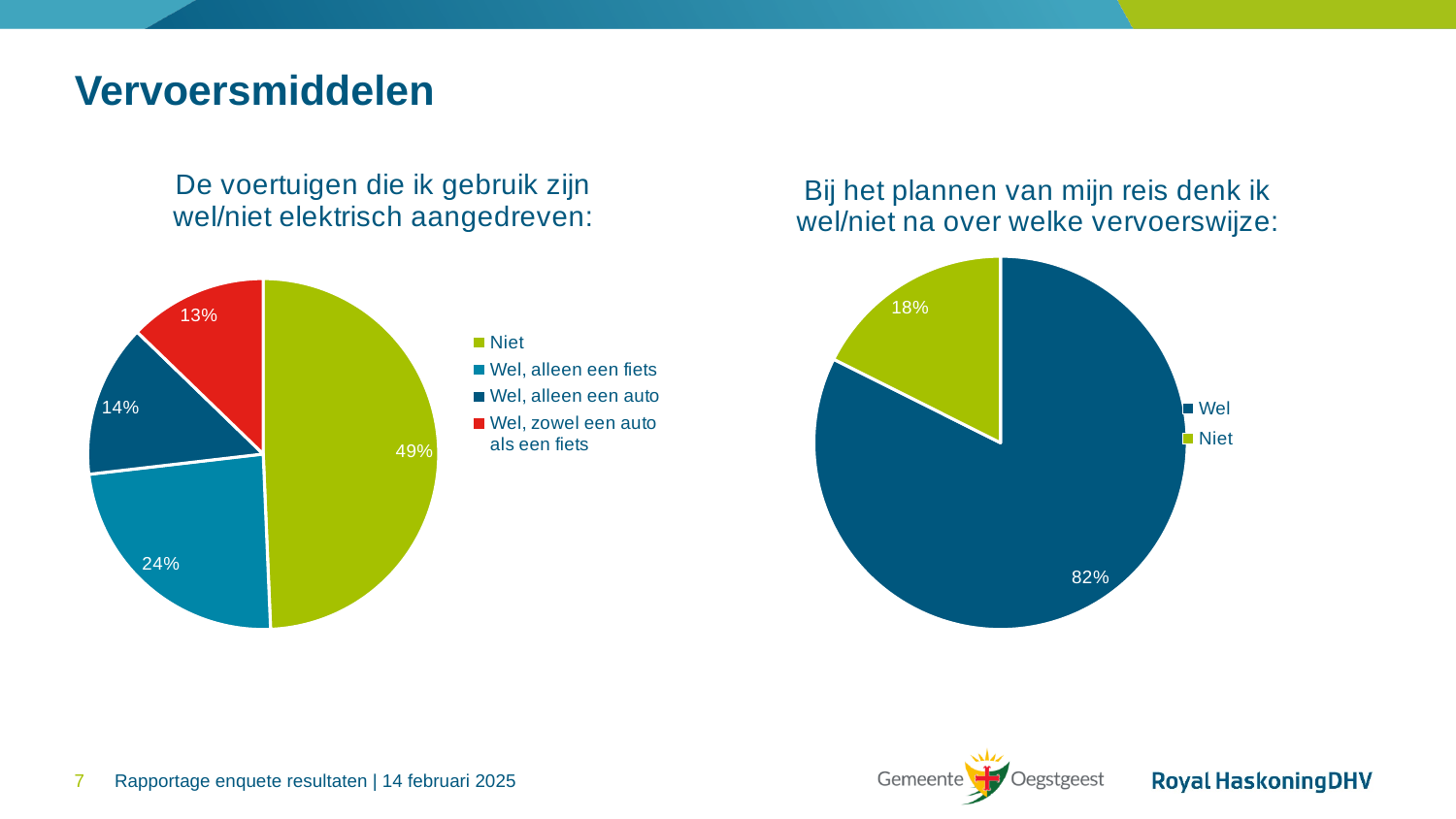
In the left chart (De voertuigen die ik gebruik zijn wel/niet elektrisch aangedreven), which category is shown in red? Wel, zowel een auto als een fiets In the right chart (Bij het plannen van mijn reis denk ik wel/niet na over welke vervoerswijze), what share is labelled for 'Niet'? 18% In the left chart (De voertuigen die ik gebruik zijn wel/niet elektrisch aangedreven), which category has the smallest slice? Wel, zowel een auto als een fiets In the left chart (De voertuigen die ik gebruik zijn wel/niet elektrisch aangedreven), how many categories does the legend list? 4 In the left chart (De voertuigen die ik gebruik zijn wel/niet elektrisch aangedreven), what share is labelled for 'Niet'? 49% In the right chart (Bij het plannen van mijn reis denk ik wel/niet na over welke vervoerswijze), which is larger, 'Wel' or 'Niet'? Wel In the left chart (De voertuigen die ik gebruik zijn wel/niet elektrisch aangedreven), what share is labelled for 'Wel, alleen een fiets'? 24% In the right chart (Bij het plannen van mijn reis denk ik wel/niet na over welke vervoerswijze), what share is labelled for 'Wel'? 82% In the left chart (De voertuigen die ik gebruik zijn wel/niet elektrisch aangedreven), what is the difference in percentage points between 'Niet' and 'Wel, alleen een fiets'? 25 In the left chart (De voertuigen die ik gebruik zijn wel/niet elektrisch aangedreven), which category has the largest slice? Niet What type of chart is used for the right chart (Bij het plannen van mijn reis denk ik wel/niet na over welke vervoerswijze)? Pie chart In the left chart (De voertuigen die ik gebruik zijn wel/niet elektrisch aangedreven), what share is labelled for 'Wel, zowel een auto als een fiets'? 13%